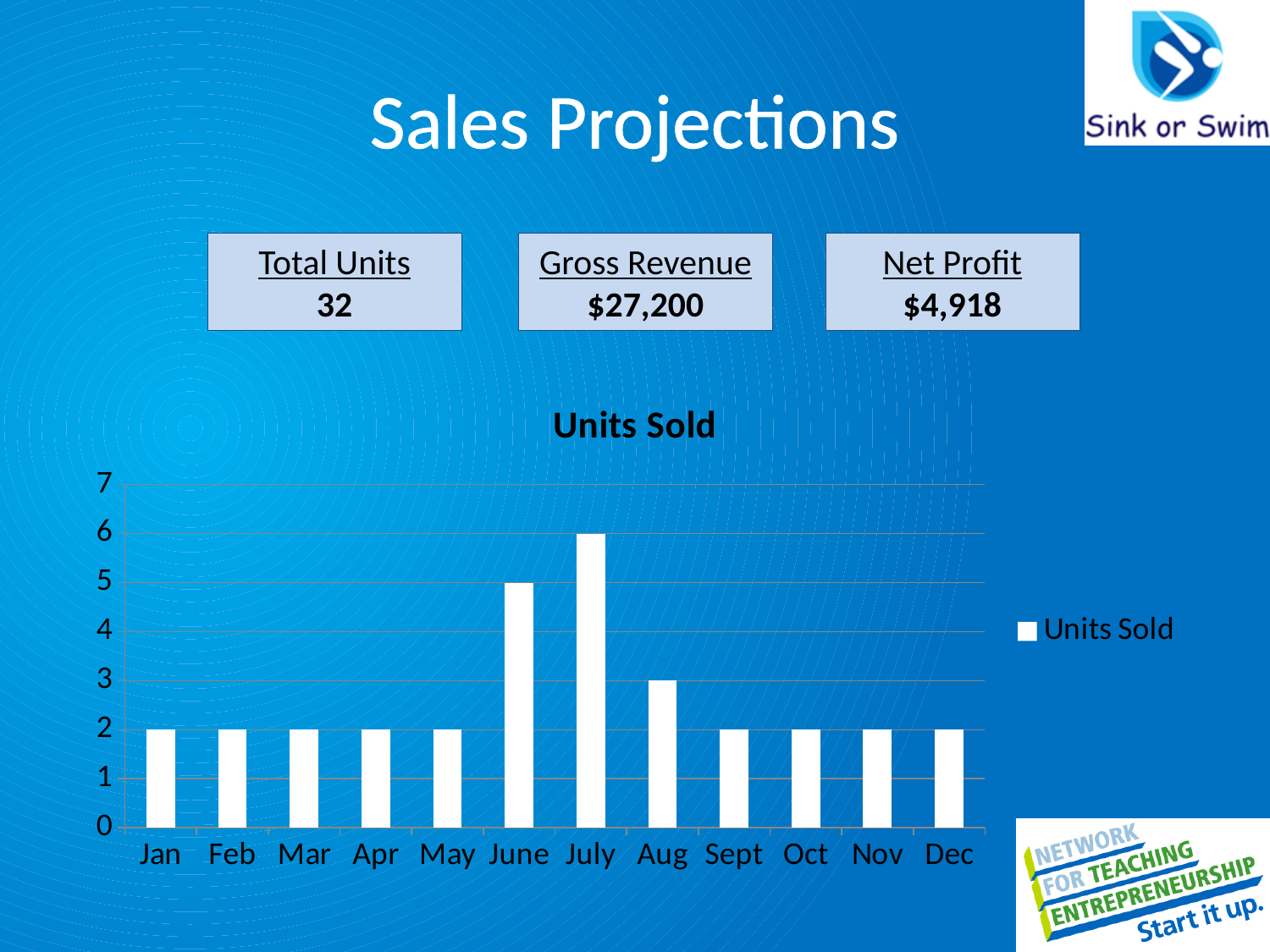
What is the value for Jan? 2 How many months are shown on the x axis of the chart? 12 What is the value for Aug? 3 What is the title of the chart? Units Sold Which month has the highest units sold? July Is the value for July greater or less than 4? greater What is the value for June? 5 What kind of chart is shown on the slide? bar chart Which is larger, the value for June or the value for Aug? June What is the difference between the values for July and June? 1 What is the value for July? 6 How many series does the legend list? 1